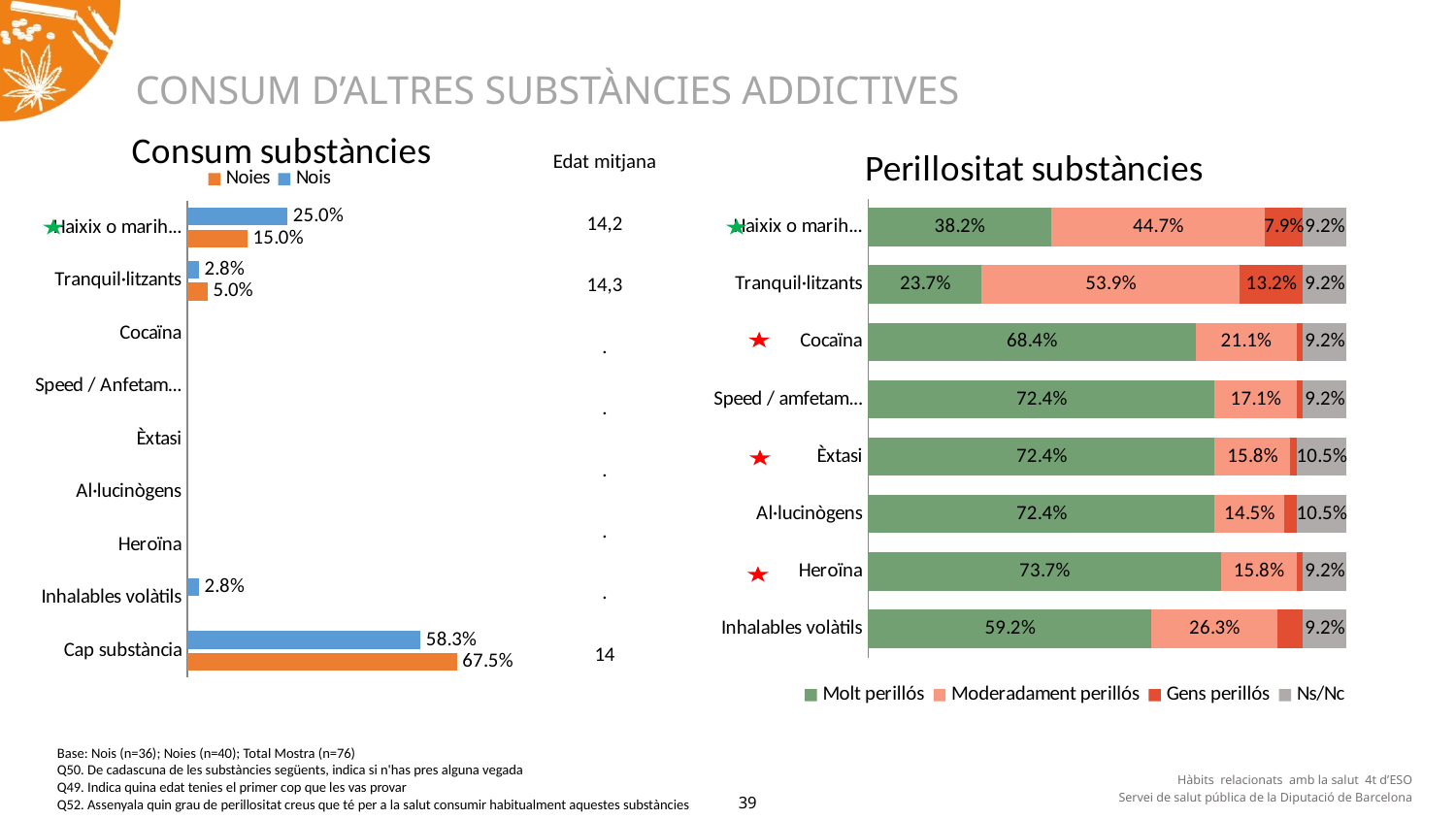
How many categories are shown in the 'Perillositat substàncies' chart? 8 In the 'Consum substàncies' chart, what is the value for Noies for 'Tranquil·litzants'? 5.0% In the 'Consum substàncies' chart, what is the difference between the Noies and Nois values for 'Cap substància'? 9.2% In the 'Perillositat substàncies' chart, which category has the lowest 'Molt perillós' value? Tranquil·litzants How many series does the legend of the 'Consum substàncies' chart list? 2 How many series does the legend of the 'Perillositat substàncies' chart list? 4 In the 'Perillositat substàncies' chart, what is the 'Moderadament perillós' value for 'Tranquil·litzants'? 53.9% In the 'Perillositat substàncies' chart, what is the 'Molt perillós' value for 'Heroïna'? 73.7% What kind of chart is 'Perillositat substàncies'? Stacked bar chart In the 'Consum substàncies' chart, what is the value for Nois for 'Cap substància'? 58.3% In the 'Consum substàncies' chart, which is larger for 'Haixix o marih...': the Nois value or the Noies value? Nois In the 'Perillositat substàncies' chart, which category has the highest 'Molt perillós' value? Heroïna